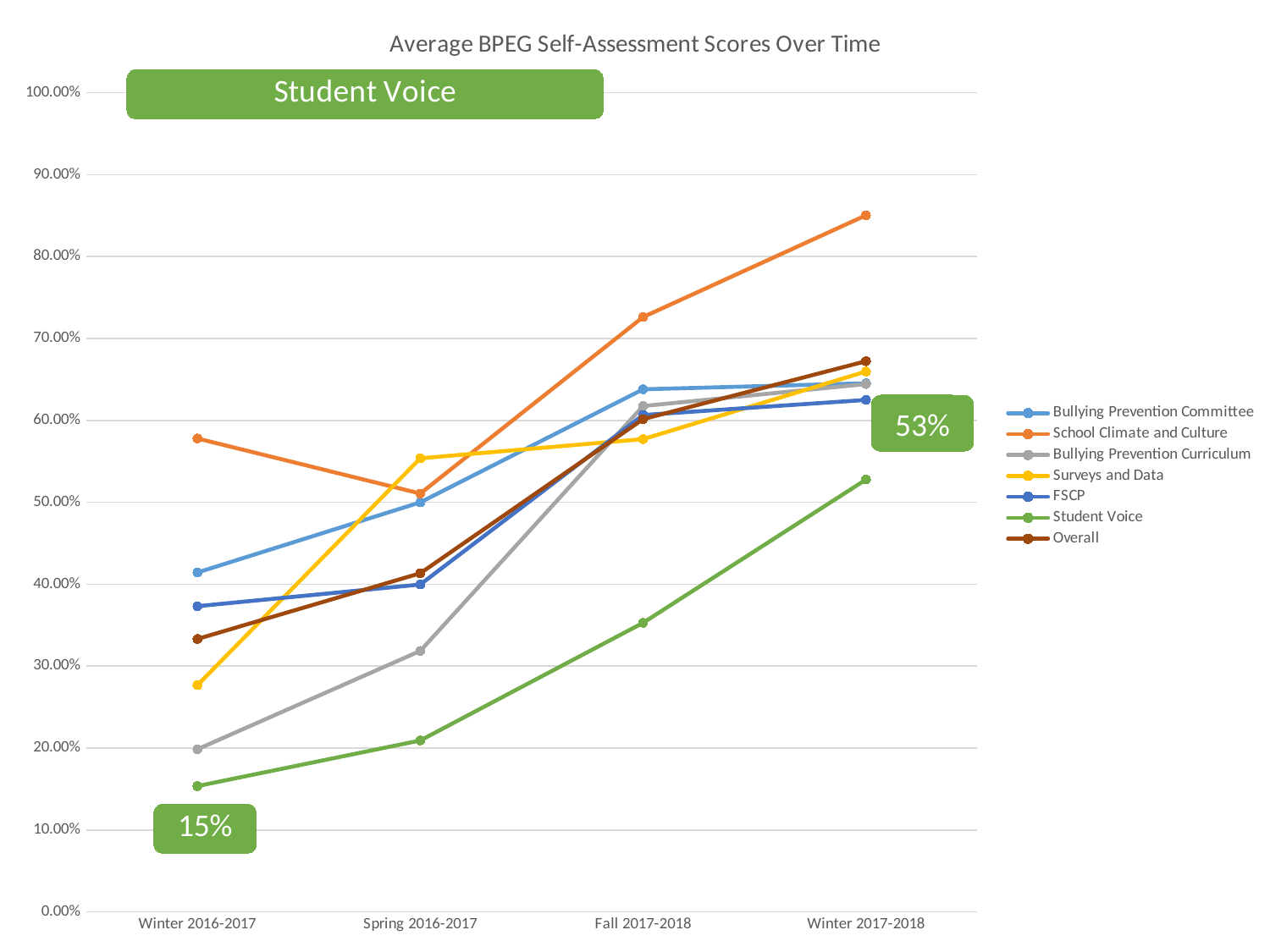
At Winter 2016-2017, which is higher: School Climate and Culture or Bullying Prevention Committee? School Climate and Culture Does the Overall series rise or fall from Winter 2016-2017 to Winter 2017-2018? rise How many series does the legend list? 7 According to the callout on the slide, what was the Student Voice score at Winter 2017-2018? 53% Which series has the highest value at Winter 2017-2018? School Climate and Culture Is the value for Bullying Prevention Curriculum at Winter 2016-2017 greater or less than 30.00%? less What kind of chart is shown on the slide? line chart Is the value for School Climate and Culture at Winter 2017-2018 greater or less than 80.00%? greater How many time periods are shown on the x axis? 4 Using the two callout values, by how much did the Student Voice score increase from Winter 2016-2017 to Winter 2017-2018? 38% According to the callout on the slide, what was the Student Voice score at Winter 2016-2017? 15% Which series has the lowest value at Winter 2016-2017? Student Voice